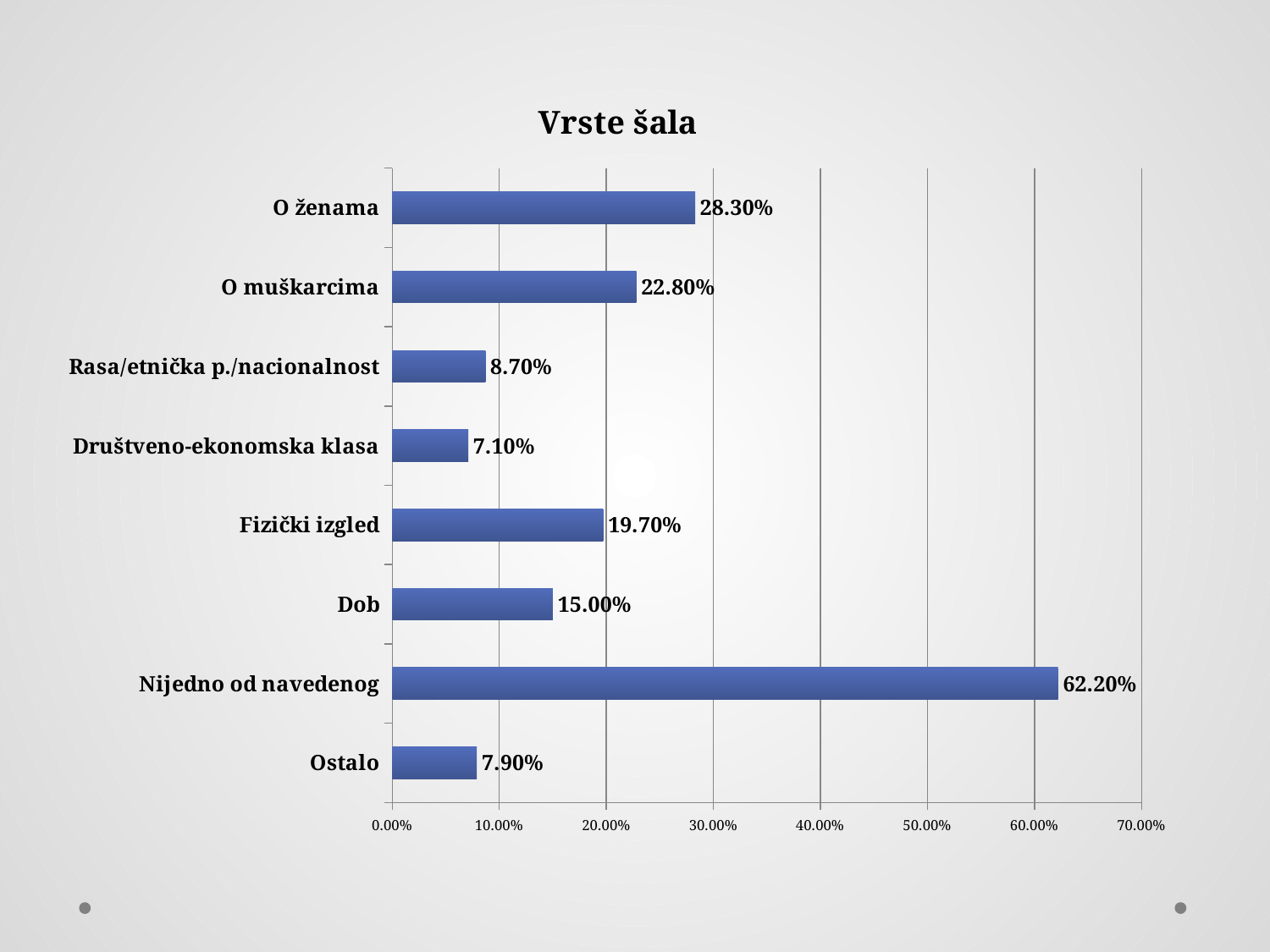
Which category has the lowest value? Društveno-ekonomska klasa Which is larger, the value for "Dob" or the value for "Fizički izgled"? Fizički izgled What is the difference between the values for "Rasa/etnička p./nacionalnost" and "Ostalo"? 0.80% What is the title of the chart? Vrste šala Is the value for "Nijedno od navedenog" greater or less than 50.00%? greater What is the value for "Fizički izgled"? 19.70% What is the value for "Nijedno od navedenog"? 62.20% Which category has the highest value? Nijedno od navedenog How many categories are shown in the chart? 8 What kind of chart is shown on the slide? bar chart What is the value for "O ženama"? 28.30% What is the difference between the values for "O ženama" and "O muškarcima"? 5.50%